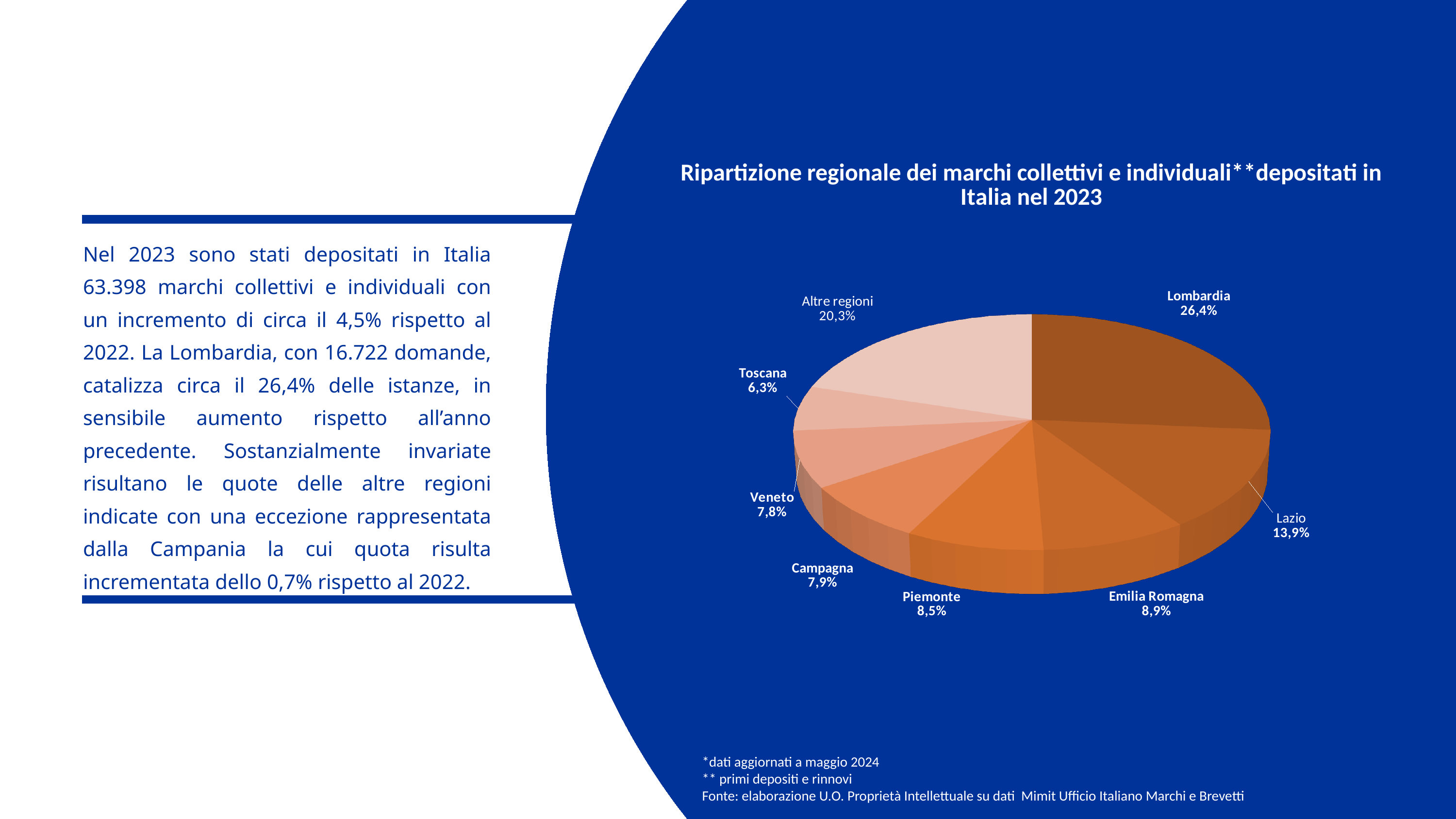
What is the value shown for Lazio? 13,9% What is the value shown for Altre regioni? 20,3% How many slices does the pie chart have? 8 What is the title of the chart? Ripartizione regionale dei marchi collettivi e individuali** depositati in Italia nel 2023 What is the difference between the values for Emilia Romagna and Toscana? 2,6% Which slice of the pie is the smallest? Toscana Which is larger, the share of Piemonte or the share of Veneto? Piemonte What kind of chart is shown on the slide? Pie chart What share of the pie does Lombardia hold? 26,4% Which region has the largest slice of the pie? Lombardia What is the difference between the shares of Lombardia and Lazio? 12,5% What percentage is shown for Emilia Romagna? 8,9%